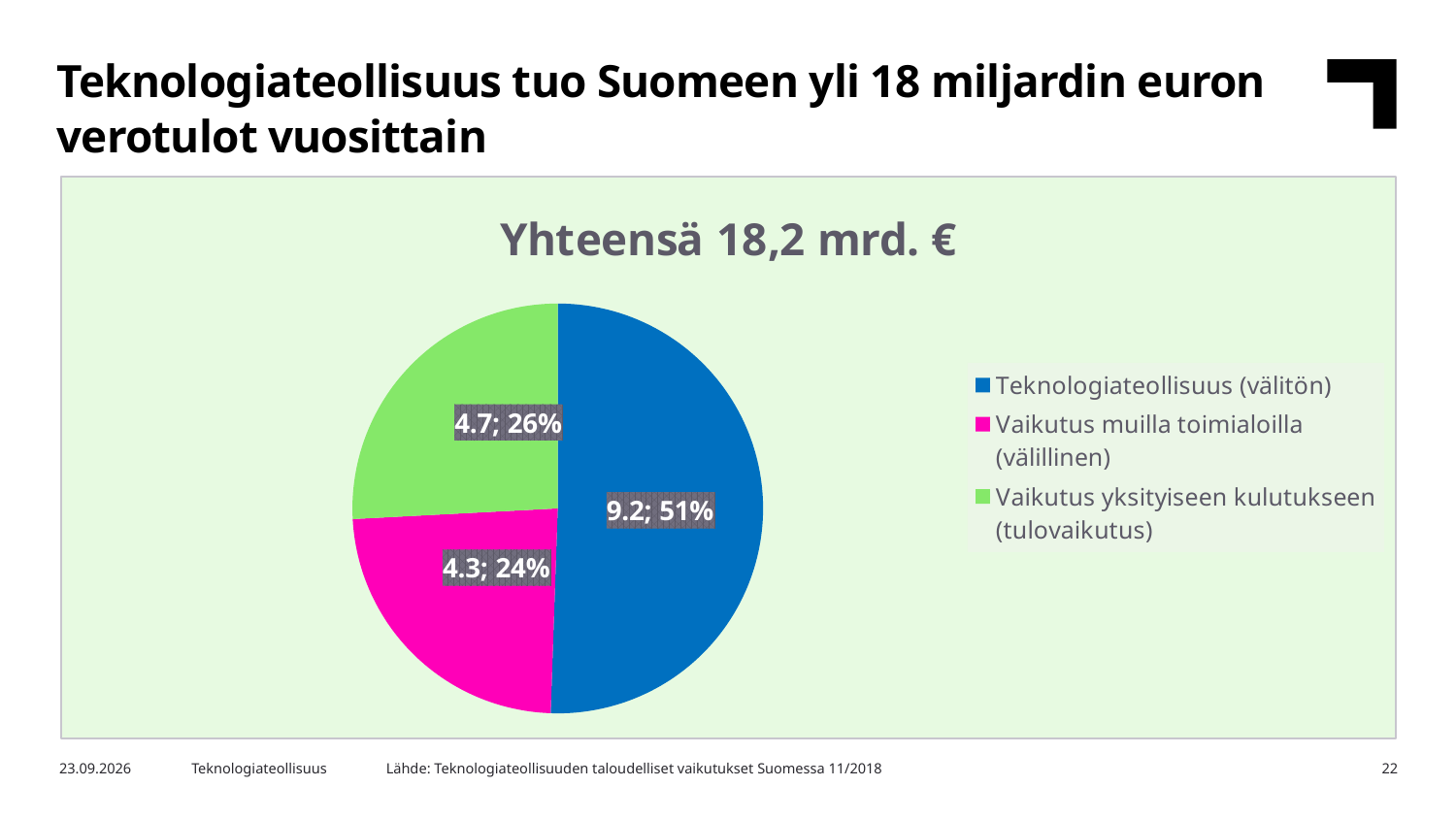
Which slice is the largest? Teknologiateollisuus (välitön) Which slice is the smallest? Vaikutus muilla toimialoilla (välillinen) What value is shown for Teknologiateollisuus (välitön)? 9.2 What is the difference between the values for Teknologiateollisuus (välitön) and Vaikutus muilla toimialoilla (välillinen)? 4.9 What share of the pie does Vaikutus yksityiseen kulutukseen (tulovaikutus) represent? 26% What kind of chart is shown on the slide? pie chart How many slices does the pie chart have? 3 What share of the pie does Teknologiateollisuus (välitön) represent? 51% What is the chart's title? Yhteensä 18,2 mrd. € What value is shown for Vaikutus muilla toimialoilla (välillinen)? 4.3 What value is shown for Vaikutus yksityiseen kulutukseen (tulovaikutus)? 4.7 How many entries does the legend list? 3